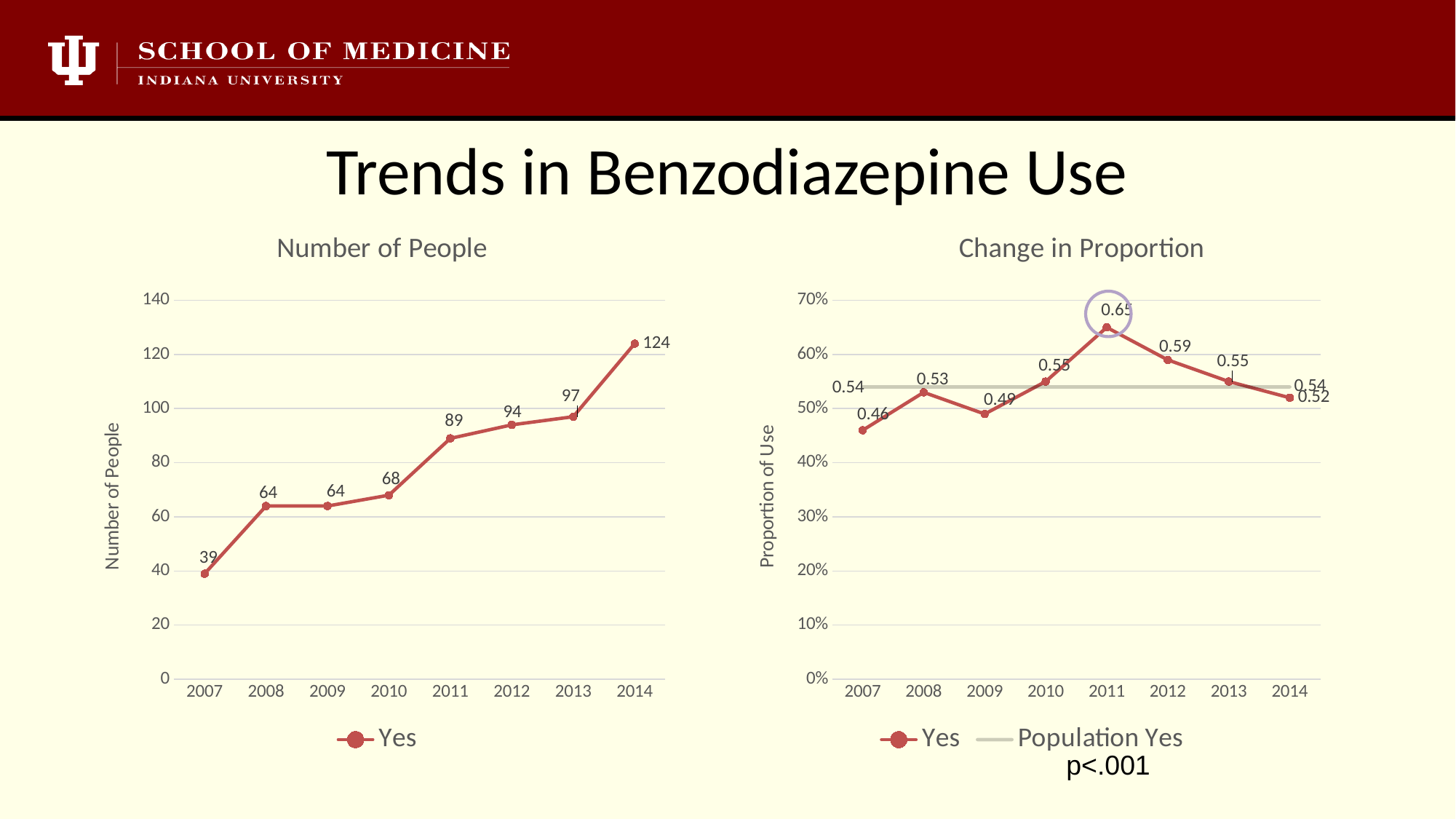
In the "Number of People" chart, which year has the highest value? 2014 In the "Number of People" chart, what is the value for 2014? 124 In the "Number of People" chart, which year has the lowest value? 2007 In the "Number of People" chart, what is the value for 2007? 39 In the "Change in Proportion" chart, which year has the lowest Yes value? 2007 In the "Change in Proportion" chart, is the Yes value for 2012 larger or smaller than the Yes value for 2013? larger In the "Number of People" chart, how many years are plotted on the x axis? 8 In the "Change in Proportion" chart, how many series does the legend list? 2 In the "Number of People" chart, what is the difference between the values for 2014 and 2013? 27 In the "Number of People" chart, do the values generally rise or fall from 2007 to 2014? rise In the "Change in Proportion" chart, what is the value of the Yes series for 2011? 0.65 What kind of chart is the "Number of People" chart? line chart